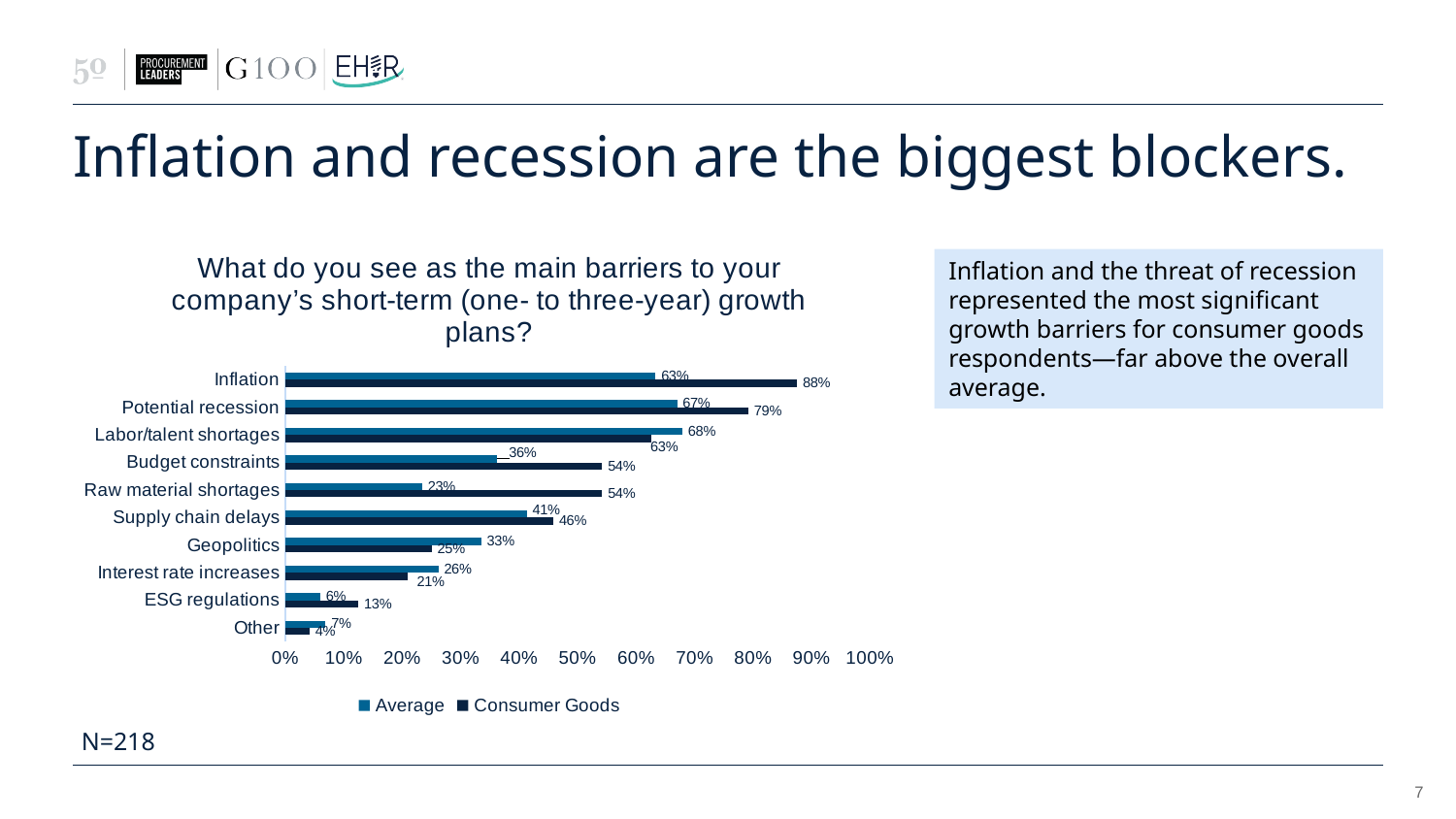
What kind of chart is shown on the slide? Bar chart What is the Average value for Raw material shortages? 23% How many categories are shown on the chart? 10 Which category has the highest Consumer Goods value? Inflation Which category has the lowest Average value? ESG regulations How many series does the legend list? 2 What is the Consumer Goods value for ESG regulations? 13% For Geopolitics, which is larger: the Average value or the Consumer Goods value? Average What is the Consumer Goods value for Inflation? 88% What is the difference between the Consumer Goods and Average values for Inflation? 25% What is the Average value for Potential recession? 67% What are the two series named in the chart legend? Average and Consumer Goods